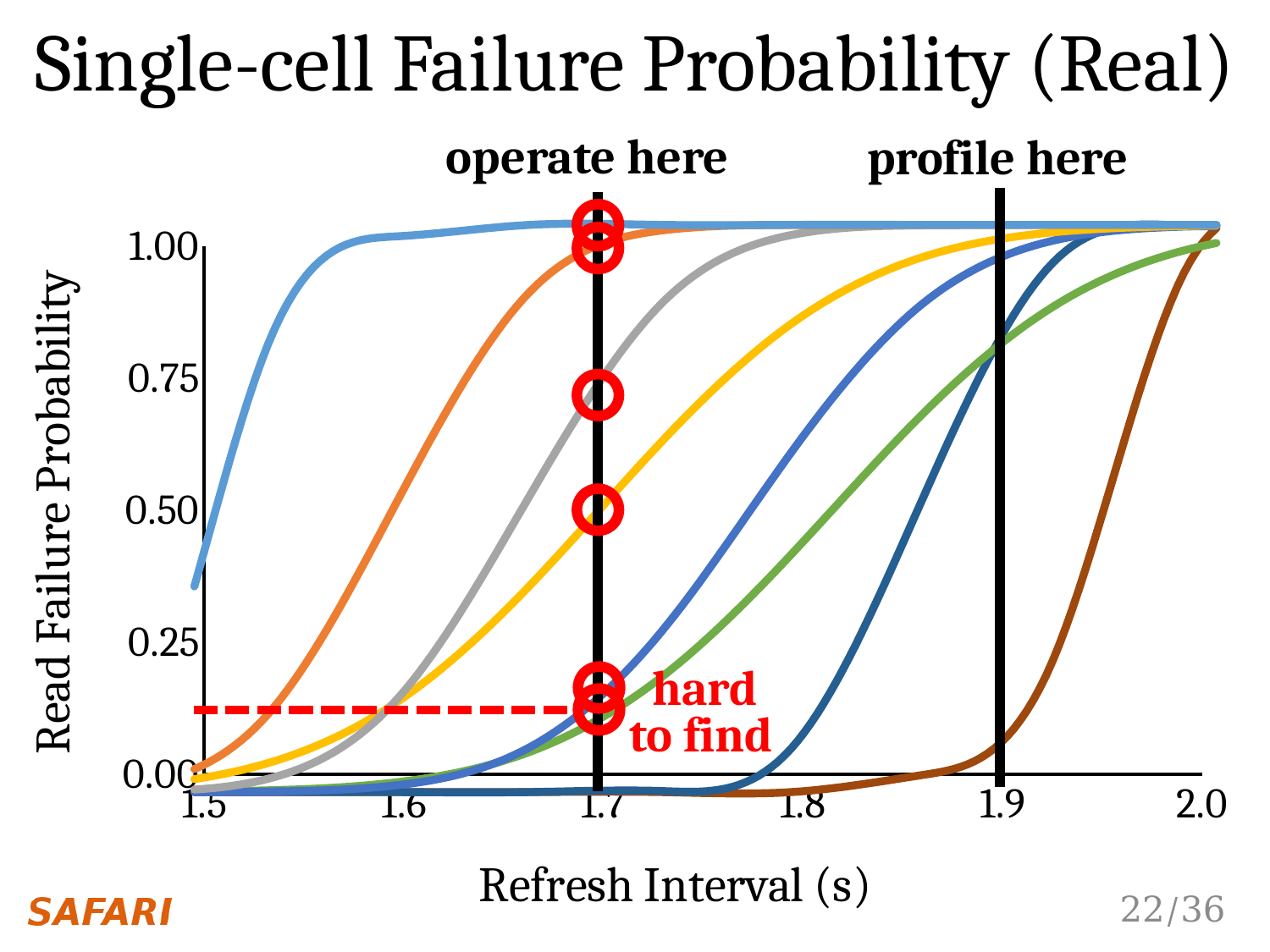
What kind of chart is shown on the slide? line chart At a refresh interval of 1.9, which curve is higher: the light blue curve or the brown curve? light blue What is the title of the slide's chart? Single-cell Failure Probability (Real) Is the value of the orange curve at a refresh interval of 1.6 greater or less than 0.50? greater Do the curves rise or fall as the refresh interval increases? rise What is the label of the x axis? Refresh Interval (s) What is the highest tick value shown on the x axis? 2.0 Is the value of the light blue curve at a refresh interval of 1.7 greater or less than 0.75? greater Is the value of the brown curve at a refresh interval of 1.9 greater or less than 0.25? less At which refresh interval is the 'operate here' vertical line drawn? 1.7 At which refresh interval is the 'profile here' vertical line drawn? 1.9